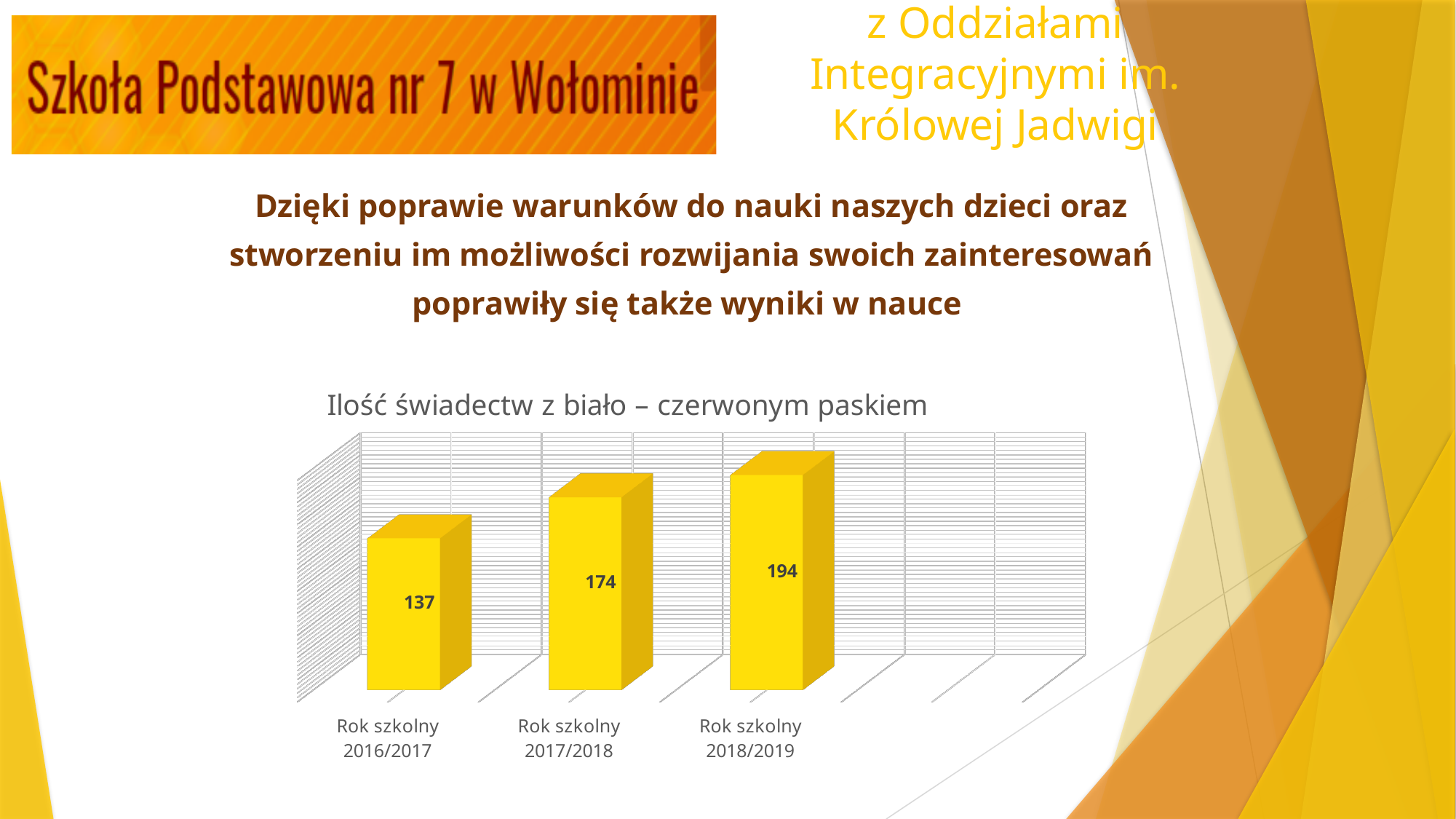
Do the values rise or fall from Rok szkolny 2016/2017 to Rok szkolny 2018/2019? rise Which school year has the lowest value? Rok szkolny 2016/2017 What is the value for Rok szkolny 2018/2019? 194 What kind of chart is shown on the slide? bar chart Which school year has the highest value? Rok szkolny 2018/2019 What is the value for Rok szkolny 2016/2017? 137 Which is larger, the value for Rok szkolny 2017/2018 or Rok szkolny 2018/2019? Rok szkolny 2018/2019 What is the difference between the values for Rok szkolny 2018/2019 and Rok szkolny 2016/2017? 57 What is the title of the chart? Ilość świadectw z biało – czerwonym paskiem What is the value for Rok szkolny 2017/2018? 174 What is the difference between the values for Rok szkolny 2017/2018 and Rok szkolny 2016/2017? 37 How many school years are shown in the chart? 3